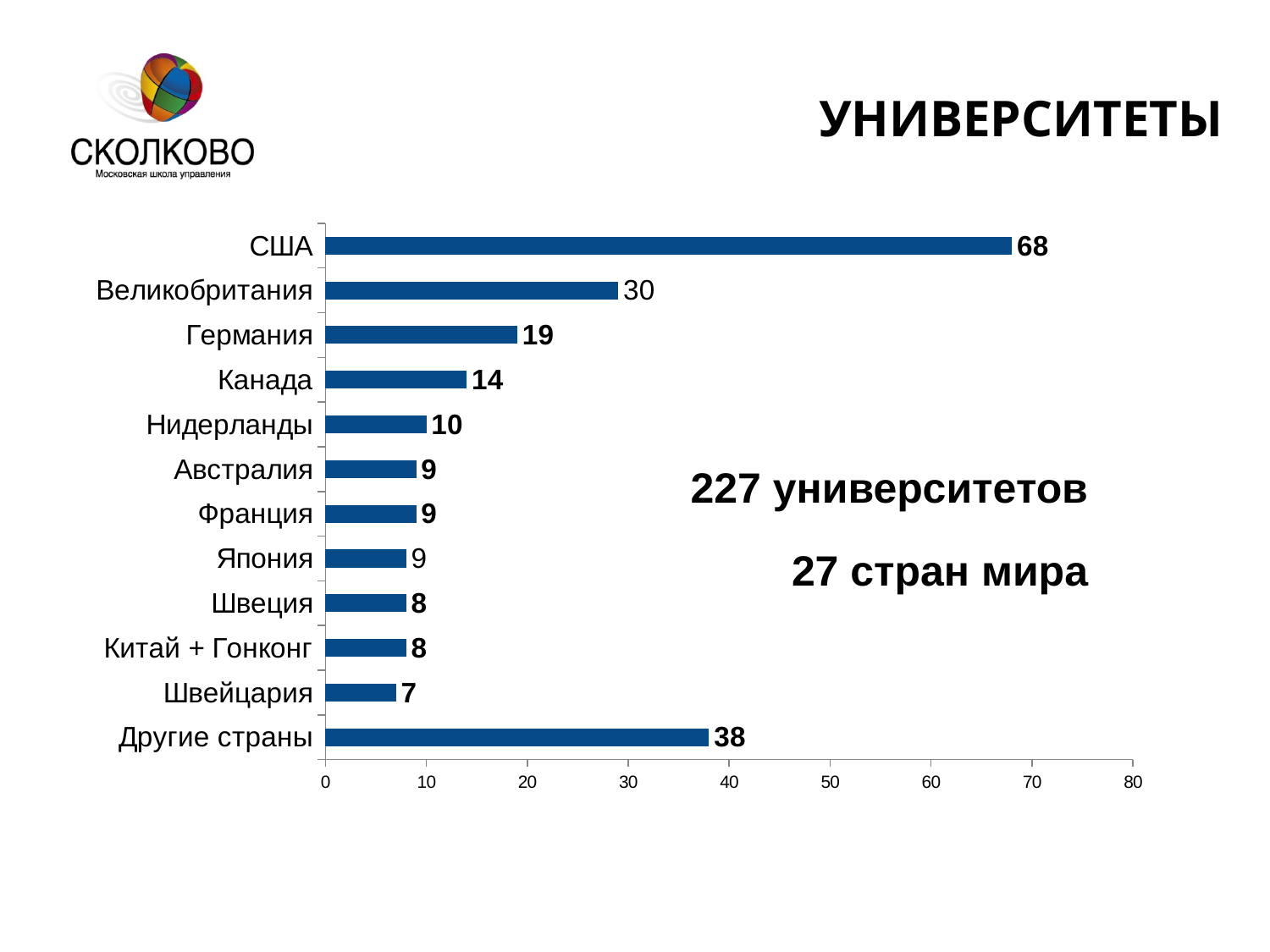
What is the value for Великобритания? 30 What is the difference between the values for США and Великобритания? 38 Which category has the highest value? США What is the value for Нидерланды? 10 Which category has the lowest value? Швейцария What is the title of the slide? УНИВЕРСИТЕТЫ What is the value for Другие страны? 38 What is the difference between the values for Германия and Канада? 5 What is the value for США? 68 What kind of chart is shown on the slide? bar chart Which is larger, the value for Другие страны or the value for Великобритания? Другие страны How many categories are shown in the chart? 12